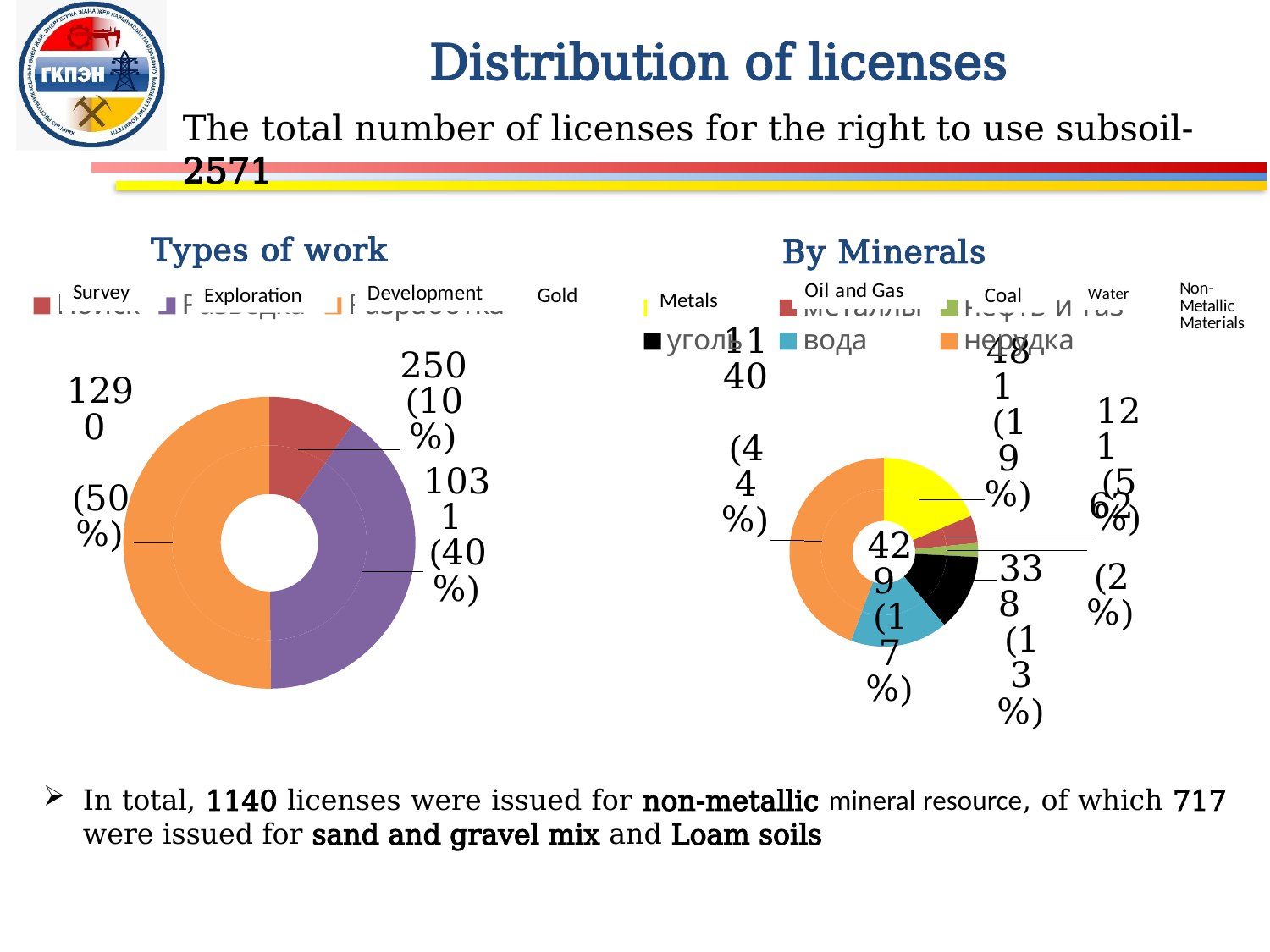
In the "Types of work" chart, which type of work has the largest share? Development In the "By Minerals" chart, which mineral has the largest share? Non-Metallic Materials What kind of chart is the "Types of work" chart? doughnut chart In the "Types of work" chart, which type of work has the smallest share? Survey How many entries does the legend of the "By Minerals" chart list? 6 In the "Types of work" chart, what share of licenses is for Survey? 10% In the "Types of work" chart, what share of licenses is for Development? 50% In the "By Minerals" chart, how many licenses are for Oil and Gas? 62 How many categories does the "Types of work" chart show? 3 In the "By Minerals" chart, what share of licenses is for Non-Metallic Materials? 44% In the "By Minerals" chart, which mineral has the smallest share? Oil and Gas